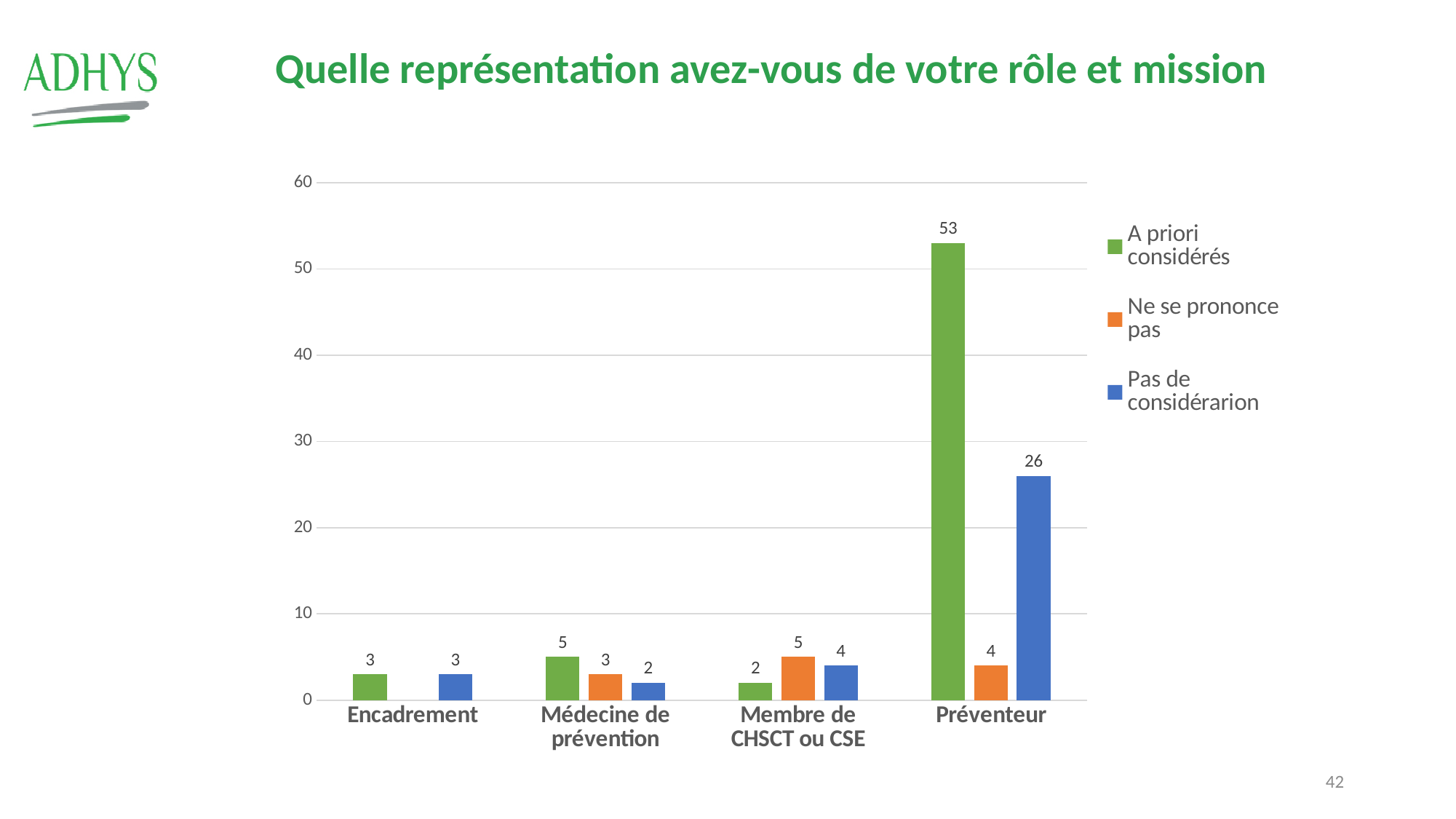
Which category has the highest value for 'A priori considérés'? Préventeur What is the value of 'Ne se prononce pas' for Membre de CHSCT ou CSE? 5 Which is larger for Membre de CHSCT ou CSE: 'Ne se prononce pas' or 'Pas de considérarion'? Ne se prononce pas How many categories are shown on the x axis? 4 What is the difference between 'A priori considérés' and 'Pas de considérarion' for Préventeur? 27 What is the value of 'A priori considérés' for Médecine de prévention? 5 What is the value of 'A priori considérés' for Préventeur? 53 Is the value of 'A priori considérés' for Préventeur greater or less than 50? greater What kind of chart is shown on the slide? Bar chart What is the value of 'Pas de considérarion' for Préventeur? 26 Which category has the lowest value for 'A priori considérés'? Membre de CHSCT ou CSE How many series does the legend list? 3